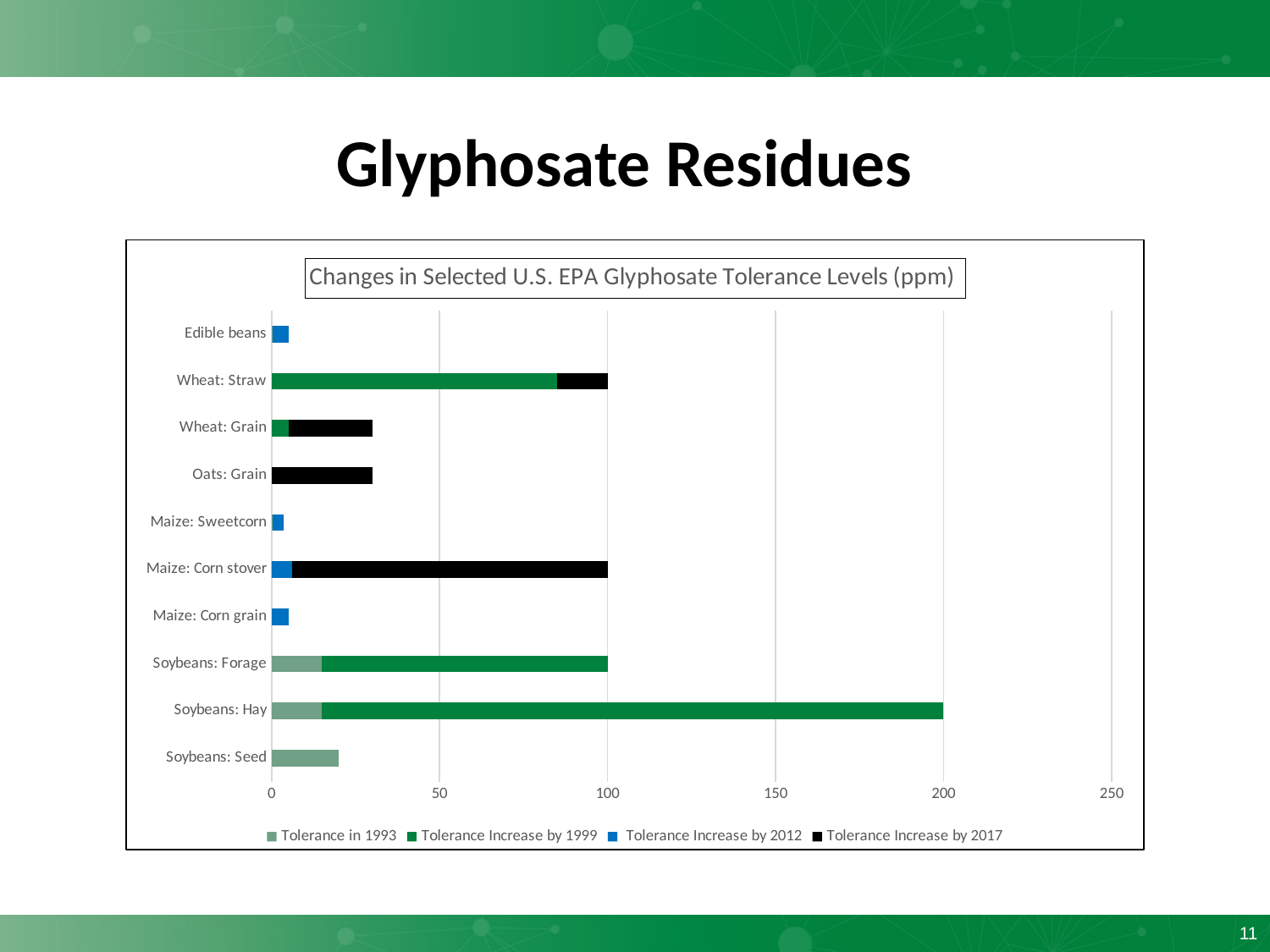
What is the total tolerance level for Soybeans: Hay? 200 Which category has the highest total tolerance level? Soybeans: Hay Is the total value for Soybeans: Seed greater or less than 50? less What type of chart is shown on the slide? bar chart Which has a larger total tolerance level, Soybeans: Hay or Soybeans: Forage? Soybeans: Hay How many series does the legend list? 4 What is the total tolerance level for Wheat: Straw? 100 What is the title of the chart? Changes in Selected U.S. EPA Glyphosate Tolerance Levels (ppm) Is the total value for Soybeans: Hay greater or less than 150? greater Is the total value for Oats: Grain greater or less than 50? less How many categories are shown on the chart? 10 Which series is shown in black in the legend? Tolerance Increase by 2017